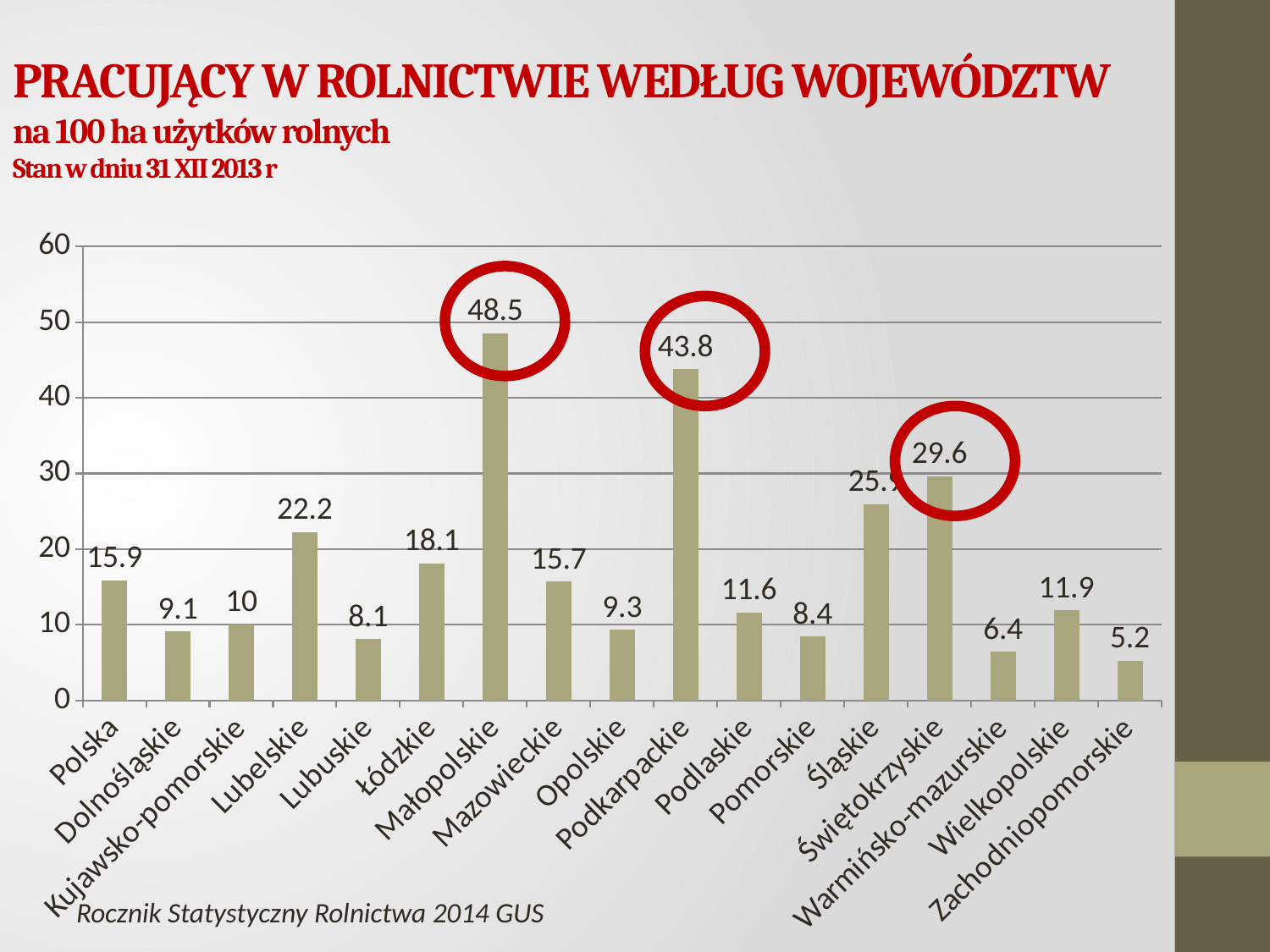
Which category has the highest value? Małopolskie Which category has the lowest value? Zachodniopomorskie Is the value for Śląskie greater or less than 20? greater Which is larger, the value for Lubelskie or the value for Łódzkie? Lubelskie What is the value for Polska? 15.9 What is the value for Małopolskie? 48.5 How many categories are shown on the x axis? 17 What source is cited below the chart? Rocznik Statystyczny Rolnictwa 2014 GUS What is the difference between the values for Małopolskie and Podkarpackie? 4.7 What kind of chart is shown on the slide? bar chart What is the value for Świętokrzyskie? 29.6 What is the value for Warmińsko-mazurskie? 6.4